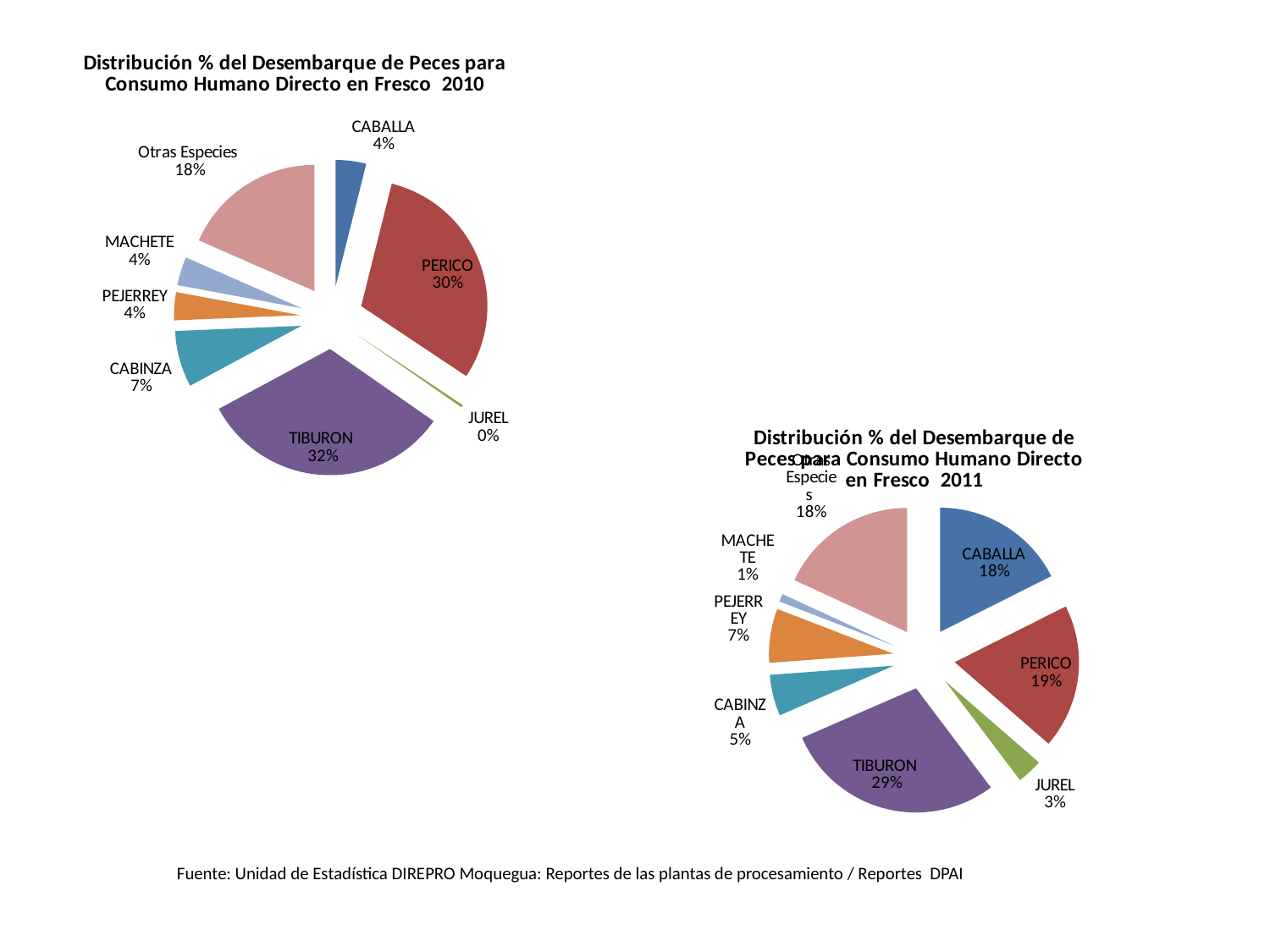
In the 2010 chart, what share of the landings is TIBURON? 32% In the 2011 chart, which species has the largest share? TIBURON In the 2010 chart, what share of the landings is PERICO? 30% What type of chart is used on this slide? Pie chart In the 2010 chart, what is the share for CABINZA? 7% What is the difference between the TIBURON share in 2010 and in 2011? 3 percentage points In the 2011 chart, what share of the landings is CABALLA? 18% In the 2010 chart, which species has the largest share? TIBURON In the 2011 chart, which is larger, the share for PEJERREY or the share for CABINZA? PEJERREY In the 2011 chart, which species has the smallest share? MACHETE In the 2010 chart, which species has the smallest share? JUREL In the 2011 chart, what is the share for JUREL? 3%